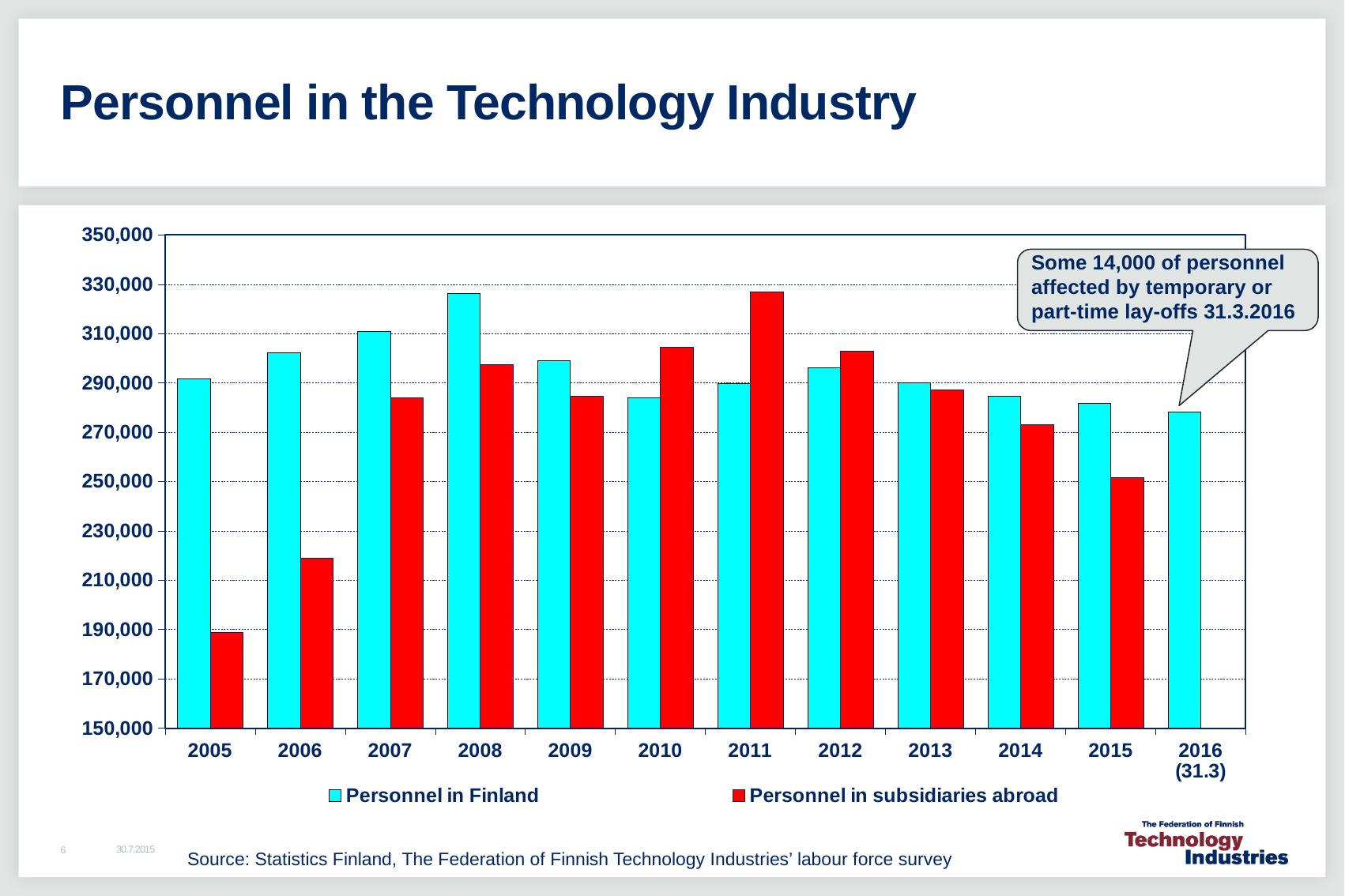
Is the value for Personnel in Finland in 2008 greater or less than 310,000? greater How many series does the legend list? 2 Is the value for Personnel in Finland in 2016 (31.3) greater or less than 290,000? less How many years are shown on the x axis? 12 In 2005, which is larger: Personnel in Finland or Personnel in subsidiaries abroad? Personnel in Finland What kind of chart is shown on the slide? Bar chart In which year is Personnel in subsidiaries abroad lowest? 2005 Does Personnel in subsidiaries abroad rise or fall from 2005 to 2011? Rise Is the value for Personnel in subsidiaries abroad in 2005 greater or less than 210,000? less In which year is Personnel in Finland highest? 2008 In which year is Personnel in subsidiaries abroad highest? 2011 In 2011, which is larger: Personnel in Finland or Personnel in subsidiaries abroad? Personnel in subsidiaries abroad